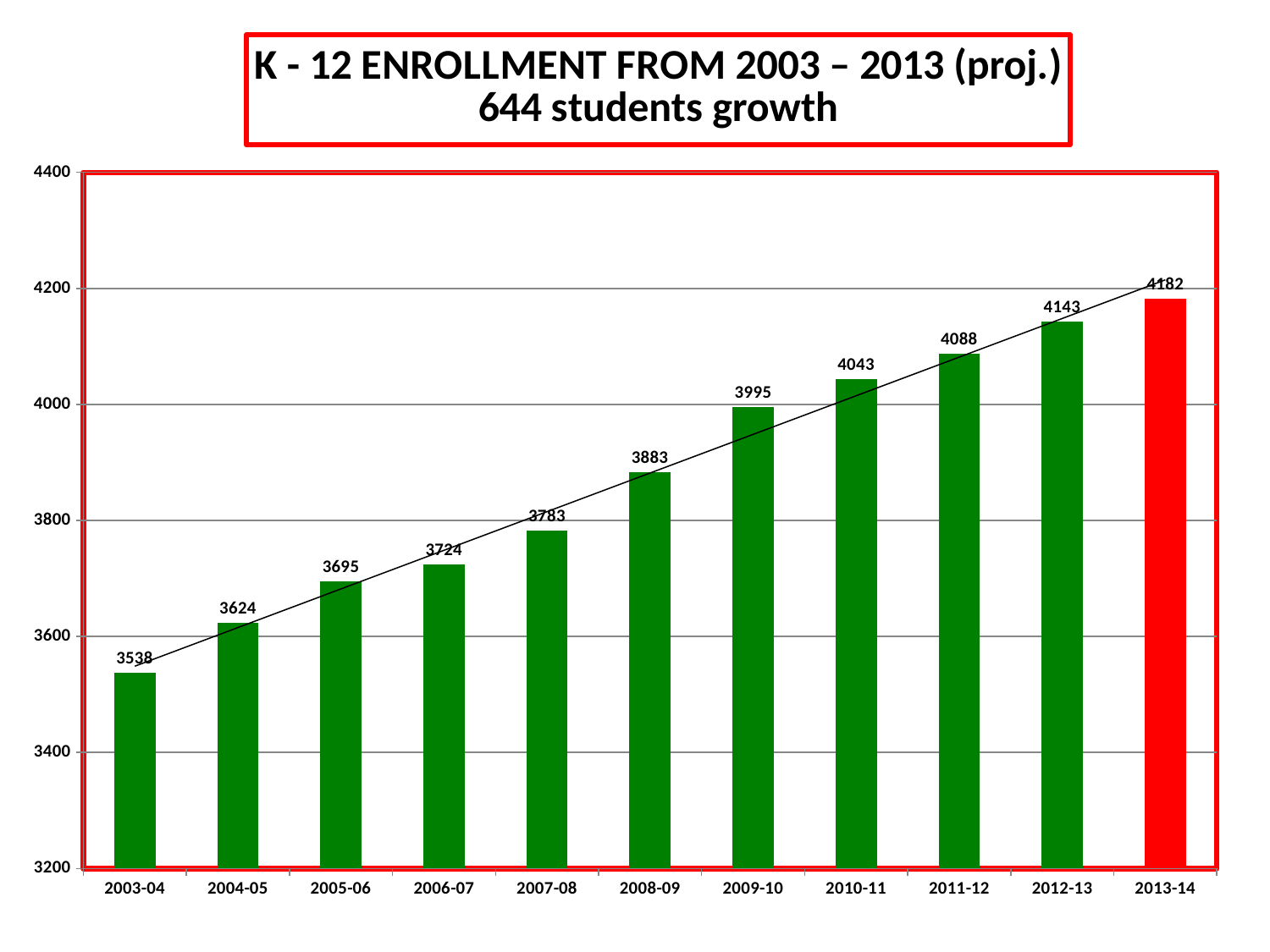
Do the enrollment values rise or fall from 2003-04 to 2013-14? rise What is the projected enrollment value for 2013-14? 4182 Is the enrollment value for 2008-09 greater or less than 4000? less How many school years are shown on the x axis? 11 Which is larger, the enrollment for 2005-06 or for 2006-07? 2006-07 What kind of chart is shown on the slide? bar chart What is the difference in enrollment between 2013-14 and 2003-04? 644 What is the difference in enrollment between 2009-10 and 2008-09? 112 Which year has the lowest enrollment? 2003-04 What is the enrollment value for 2007-08? 3783 Which year has the highest enrollment? 2013-14 What is the enrollment value for 2010-11? 4043